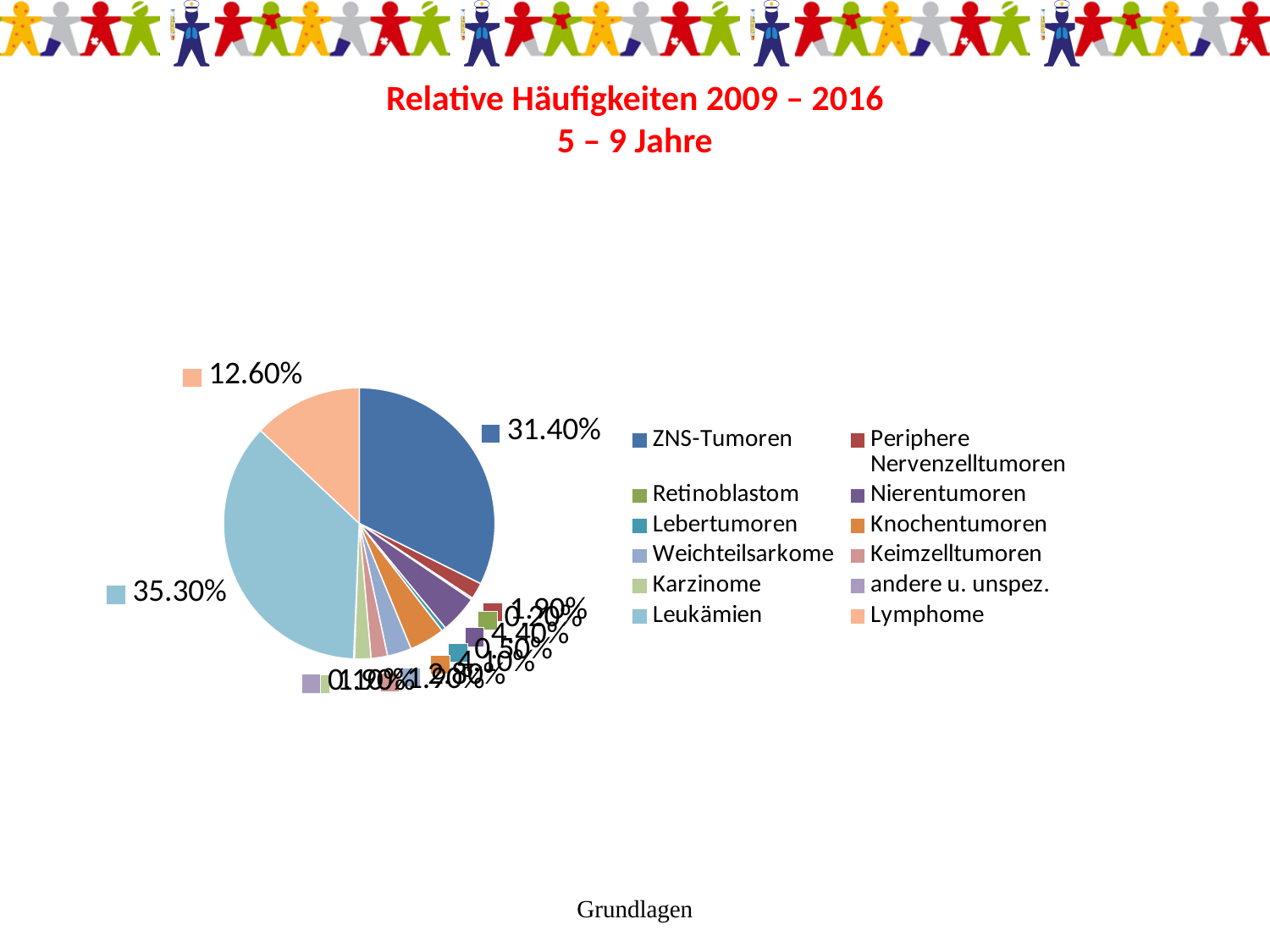
What is the share for Lymphome in the pie chart? 12.60% Which is larger, the slice for Lymphome or the slice for ZNS-Tumoren? ZNS-Tumoren What is the share for Leukämien in the pie chart? 35.30% What colour is the Lymphome slice in the pie chart? peach/light orange Which is larger, the slice for Leukämien or the slice for ZNS-Tumoren? Leukämien What type of chart is shown on the slide? pie chart What is the difference between the shares for ZNS-Tumoren and Lymphome? 18.80% Which category has the largest slice of the pie chart? Leukämien What is the share for ZNS-Tumoren in the pie chart? 31.40% What is the title of the slide containing the pie chart? Relative Häufigkeiten 2009 – 2016 5 – 9 Jahre What is the difference between the shares for Leukämien and ZNS-Tumoren? 3.90% How many categories does the legend of the pie chart list? 12